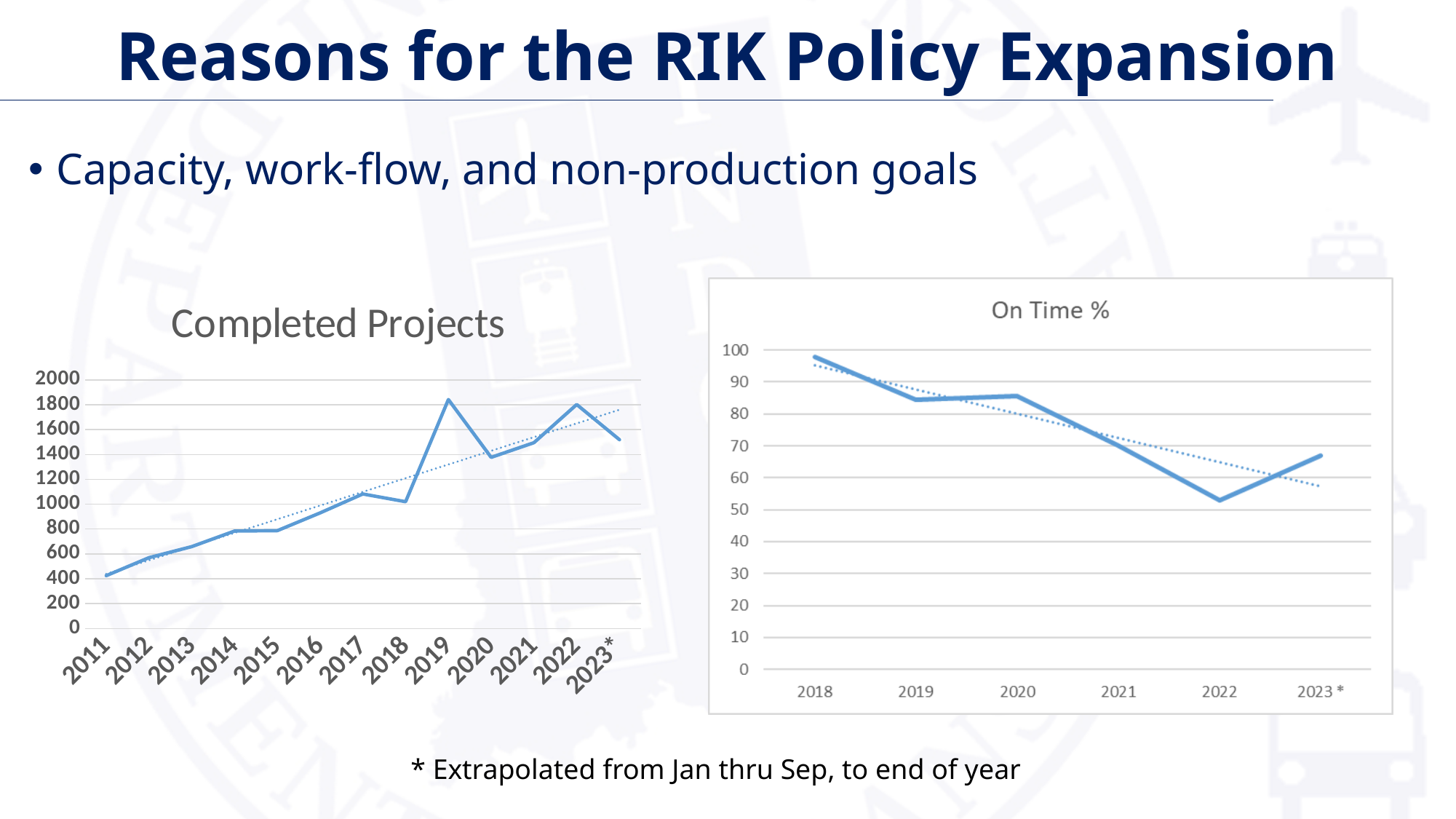
What kind of chart is the "Completed Projects" chart? line chart In the "Completed Projects" chart, is the value for 2019 greater or less than 1600? greater What kind of chart is the "On Time %" chart? line chart In the "On Time %" chart, which year has the larger value, 2018 or 2022? 2018 In the "Completed Projects" chart, how many years are plotted along the x axis? 13 In the "On Time %" chart, which year has the highest value? 2018 In the "On Time %" chart, how many years are plotted along the x axis? 6 In the "Completed Projects" chart, which year has the lowest value? 2011 In the "Completed Projects" chart, is the value for 2015 greater or less than 1000? less In the "On Time %" chart, do the values generally rise or fall from 2018 to 2022? fall In the "On Time %" chart, is the value for 2022 greater or less than 60? less In the "On Time %" chart, which year has the lowest value? 2022